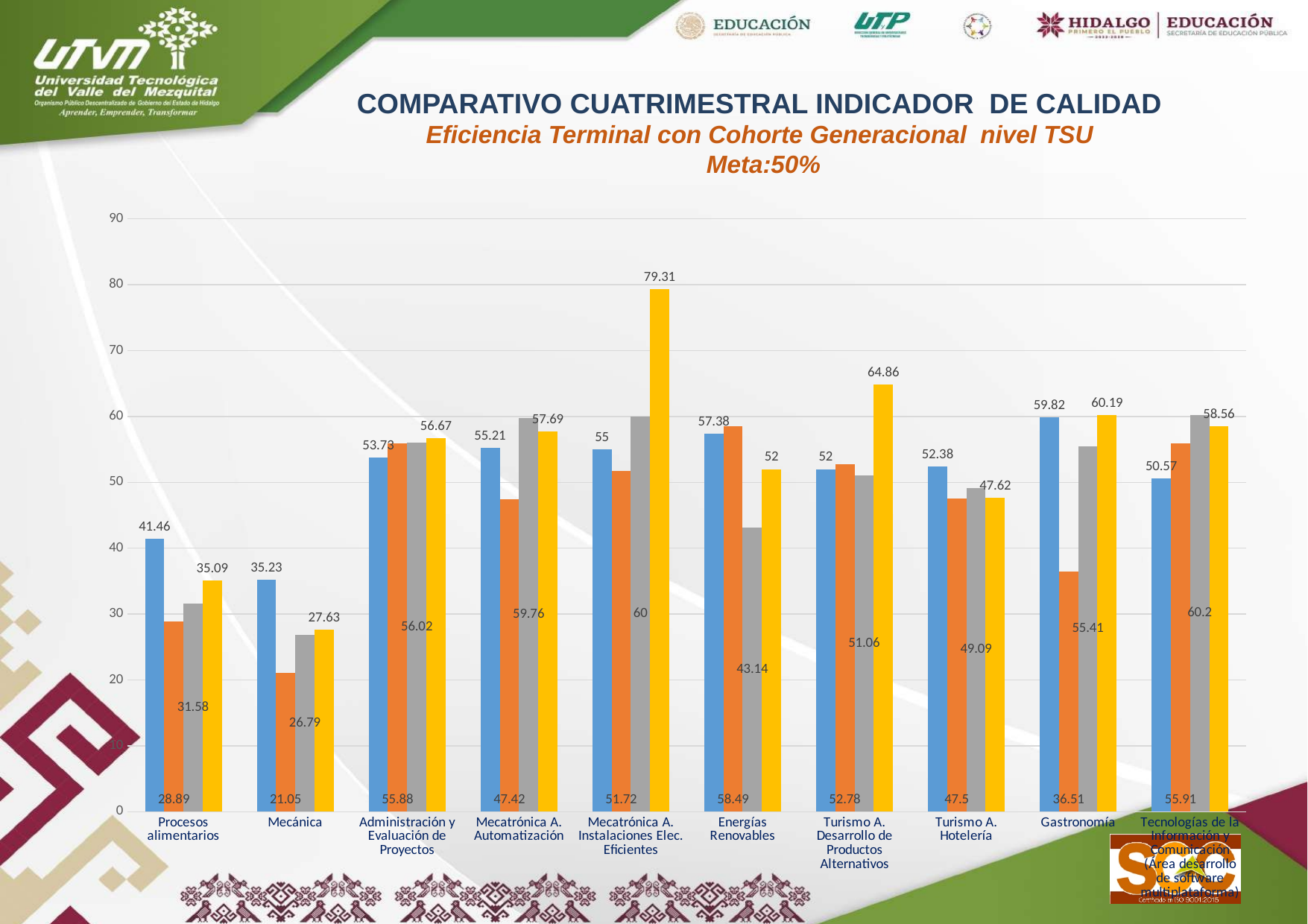
What is the value of the yellow bar for Mecatrónica A. Instalaciones Elec. Eficientes? 79.31 For Gastronomía, which is larger: the blue bar or the orange bar? the blue bar What is the value of the blue bar for Procesos alimentarios? 41.46 What is the value of the orange bar for Mecánica? 21.05 Is the value of the gray bar for Mecánica greater or less than 30? less What is the difference between the yellow bar (64.86) and the blue bar (52) for Turismo A. Desarrollo de Productos Alternativos? 12.86 Which category has the highest yellow bar? Mecatrónica A. Instalaciones Elec. Eficientes How many categories (programs) are shown on the x axis of the chart? 10 What is the value of the gray bar for Energías Renovables? 43.14 What target (Meta) is stated in the chart title? 50% What type of chart is shown on the slide? bar chart Which category has the lowest orange bar? Mecánica